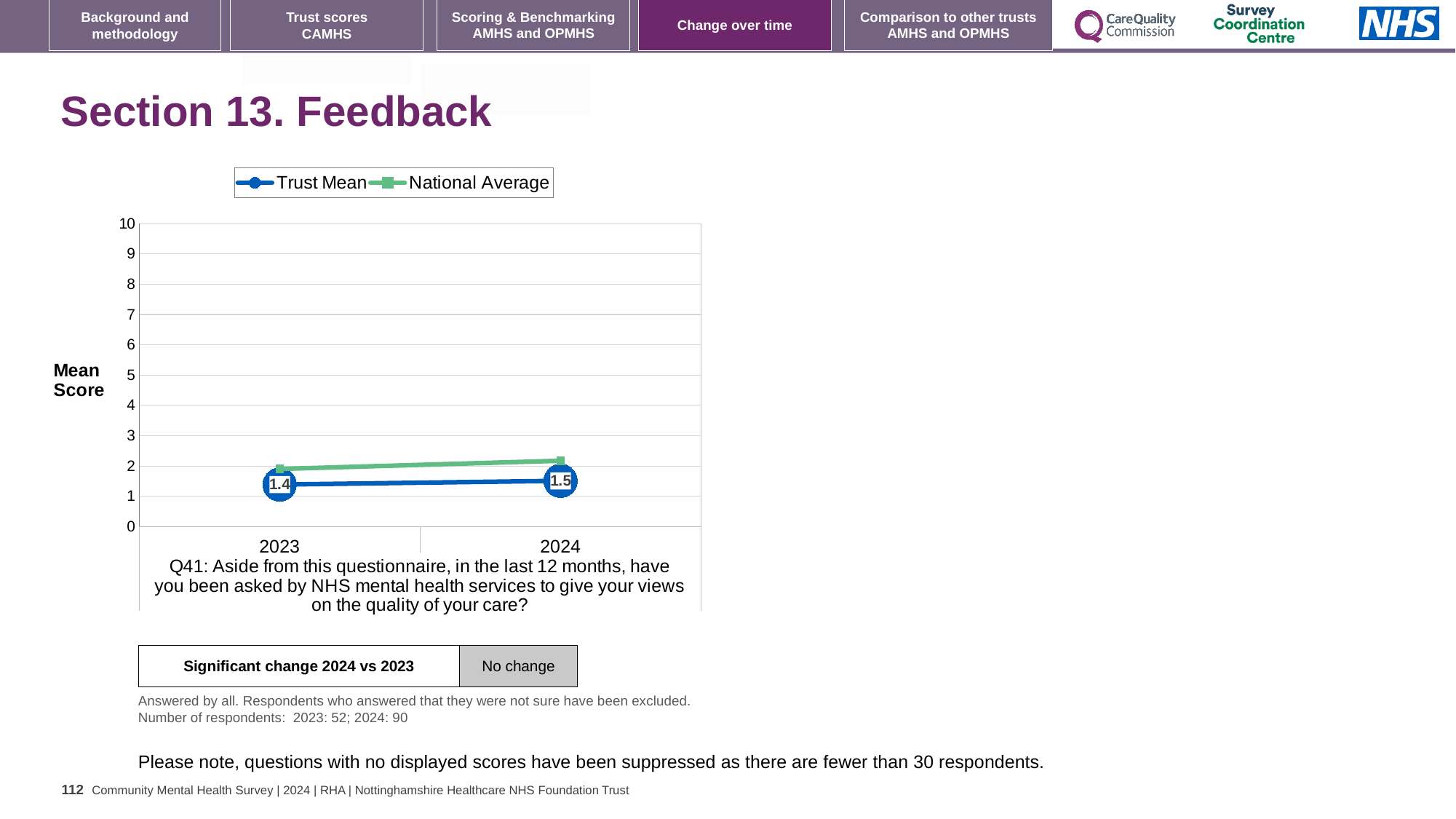
What is the label on the y axis of the chart? Mean Score What kind of chart is shown on the slide? line chart In which year is the Trust Mean higher, 2023 or 2024? 2024 What is the Trust Mean value for 2024? 1.5 What is the difference between the Trust Mean in 2024 and in 2023? 0.1 How many series does the legend list? 2 Does the Trust Mean rise or fall from 2023 to 2024? rise Is the National Average value for 2024 greater or less than 3? less How many years are plotted on the x axis? 2 Is the National Average value for 2023 greater or less than 1? greater In 2024, which is higher: the Trust Mean or the National Average? National Average What is the Trust Mean value for 2023? 1.4